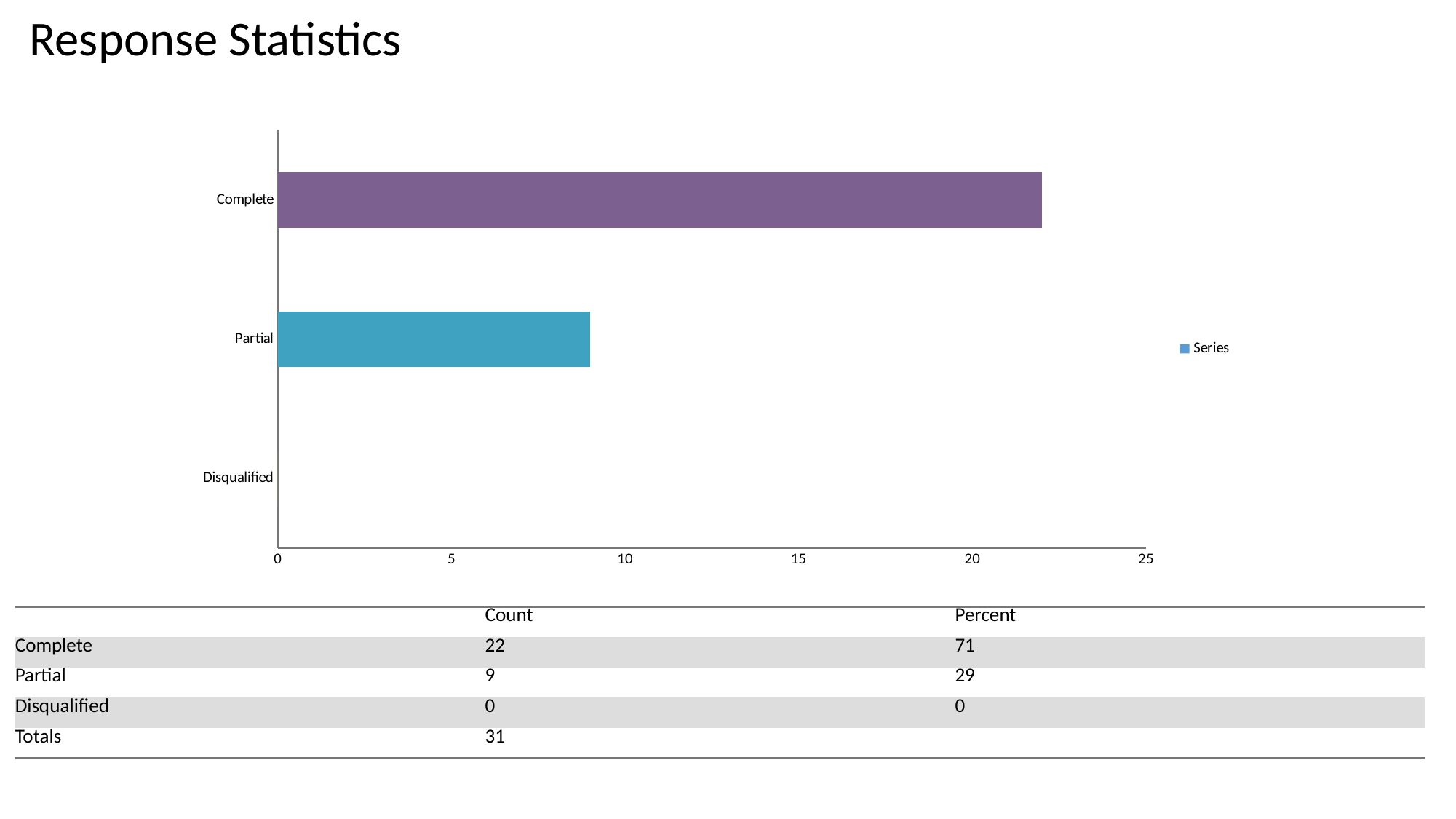
Which category has the lowest value in the chart? Disqualified What is the difference between the counts for Complete and Partial? 13 How many categories are shown on the chart's vertical axis? 3 Which category has the longest bar in the chart? Complete What kind of chart is shown on the slide? bar chart Is the value for Partial greater or less than 10? less What is the count for Partial shown on the slide? 9 What is the count for Complete shown on the slide? 22 Is the value for Complete greater or less than 20? greater How many series does the chart legend list? 1 Which is larger, the bar for Complete or the bar for Partial? Complete What is the name of the series in the chart legend? Series